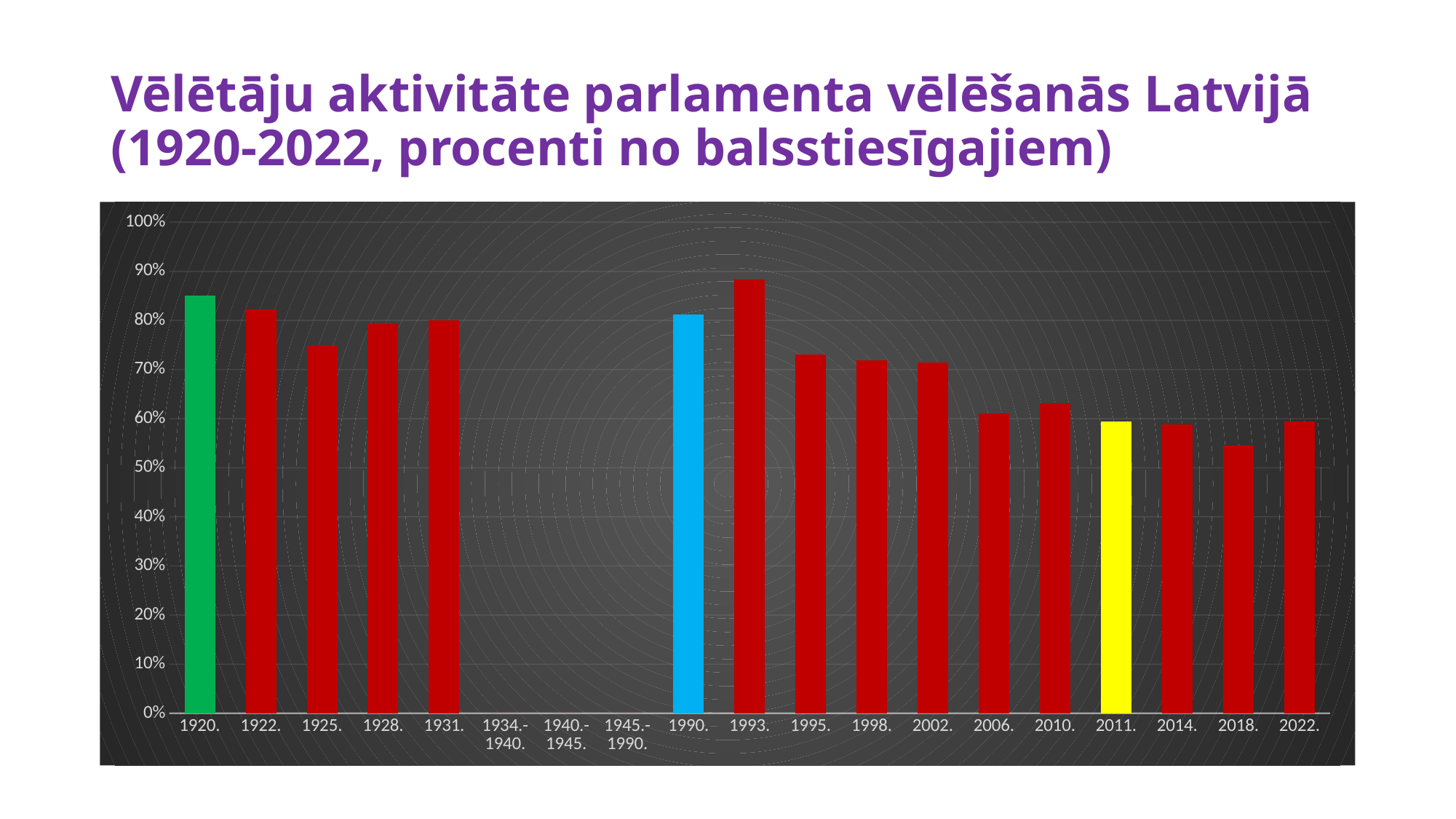
Which year has the highest voter turnout in the chart? 1993. Do the values rise or fall from 1993. to 2006.? fall What kind of chart is shown on the slide? bar chart Which year has the lowest voter turnout in the chart? 2018. Which is larger, the value for 1990. or the value for 1993.? 1993. Is the value for 1920. greater or less than 80%? greater Which is larger, the value for 1920. or the value for 1922.? 1920. How many bars are plotted in the chart? 16 What colour is the bar for 2011.? yellow Is the value for 2018. greater or less than 60%? less Is the value for 1995. greater or less than 70%? greater